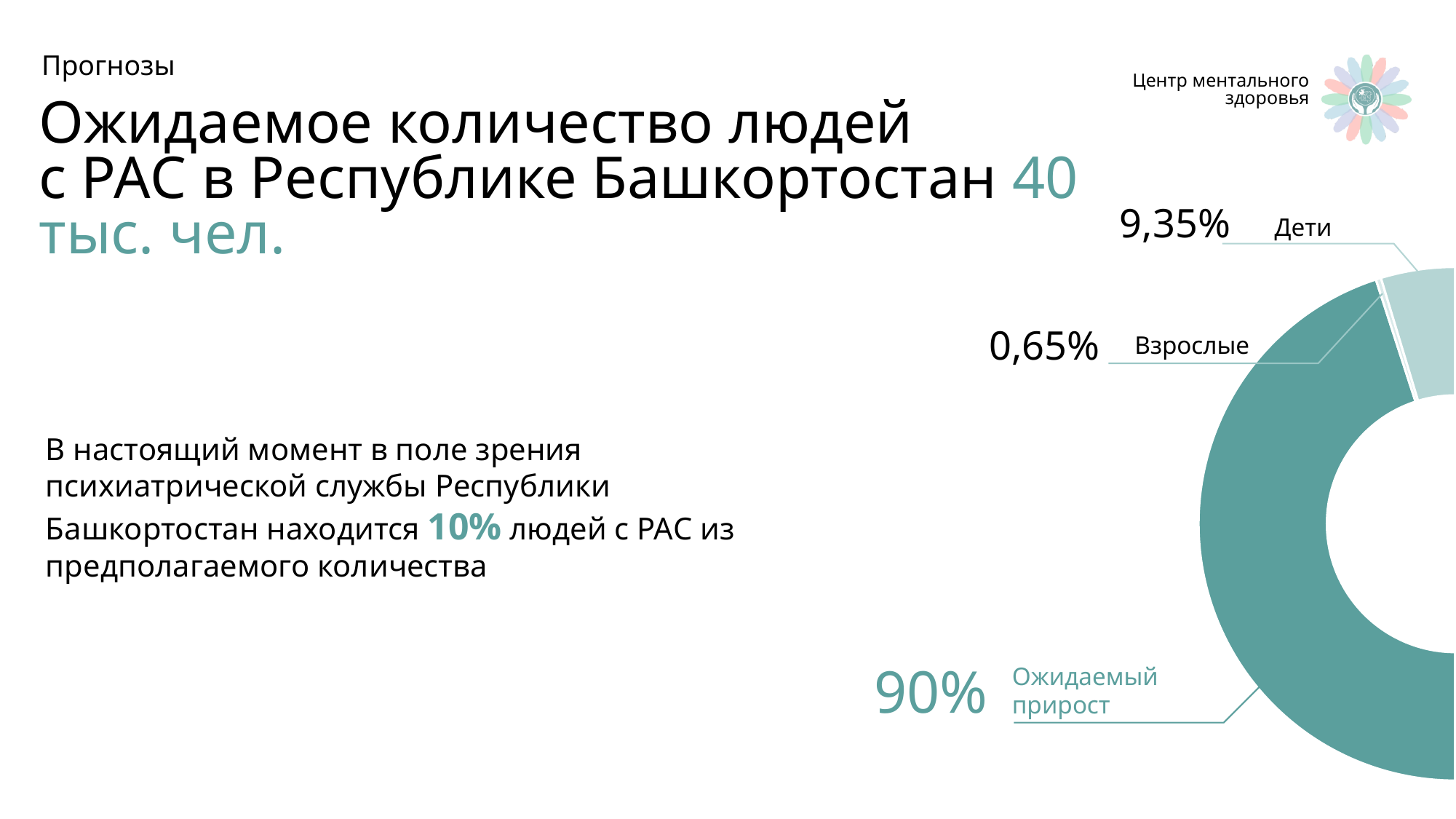
What is the difference between the Ожидаемый прирост and Дети values in the donut chart? 80,65% Which slice of the donut chart is the largest? Ожидаемый прирост What kind of chart is shown on the slide? Donut (pie) chart What expected number of people with РАС in the Republic of Bashkortostan is stated in the slide title? 40 тыс. чел. Which slice of the donut chart is the smallest? Взрослые What is the combined share of Дети and Взрослые in the donut chart? 10% What is the value for Дети in the donut chart? 9,35% What is the value for Ожидаемый прирост in the donut chart? 90% What is the difference between the Дети and Взрослые values in the donut chart? 8,7% How many slices does the donut chart have? 3 Which is larger in the donut chart, Дети or Взрослые? Дети What is the value for Взрослые in the donut chart? 0,65%